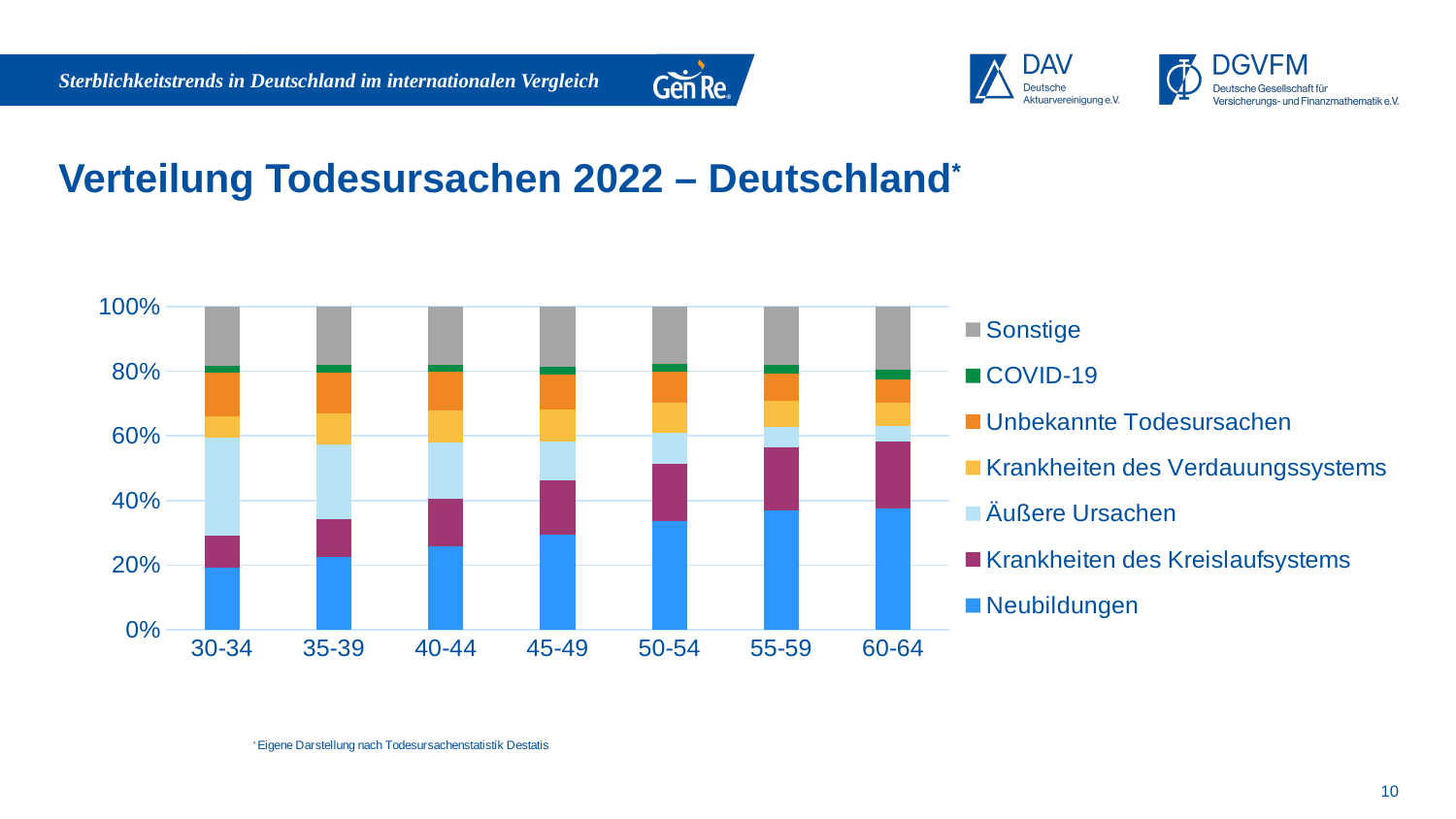
Does the share of Neubildungen rise or fall as the age groups increase from 30-34 to 60-64? rise Which age group has the largest share of Neubildungen? 60-64 Which age group has the larger share of Krankheiten des Kreislaufsystems, 30-34 or 60-64? 60-64 Is the share of Neubildungen for the 60-64 age group greater or less than 40%? less What is the title of the chart on the slide? Verteilung Todesursachen 2022 – Deutschland Is the share of Neubildungen for the 60-64 age group greater or less than 20%? greater Which series is listed first (at the top) in the chart legend? Sonstige How many age groups are shown on the x axis of the chart? 7 How many series does the chart legend list? 7 What kind of chart is shown on the slide? stacked bar chart Does the share of Äußere Ursachen rise or fall as the age groups increase from 30-34 to 60-64? fall Which age group has the largest share of Äußere Ursachen? 30-34